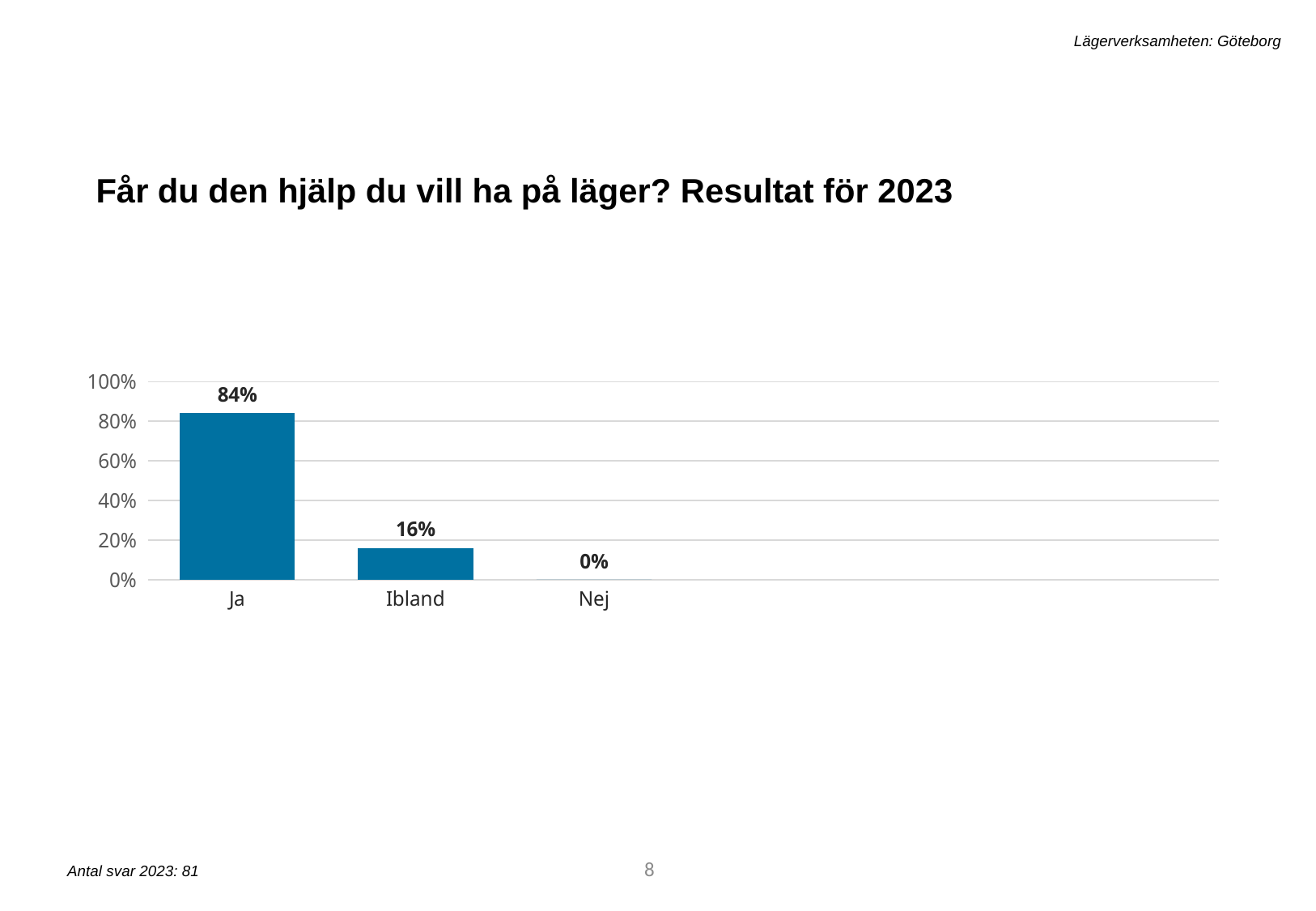
What is the value for Ibland? 16% Which category has the highest value? Ja What is the title of the slide's chart? Får du den hjälp du vill ha på läger? Resultat för 2023 Which is larger, the value for Ibland or the value for Nej? Ibland Which category has the lowest value? Nej What is the value for Nej? 0% Is the value for Ibland greater or less than 20%? less What is the value for Ja? 84% What kind of chart is shown on the slide? bar chart Is the value for Ja greater or less than 60%? greater How many categories are shown on the x axis? 3 What is the difference between the values for Ja and Ibland? 68%